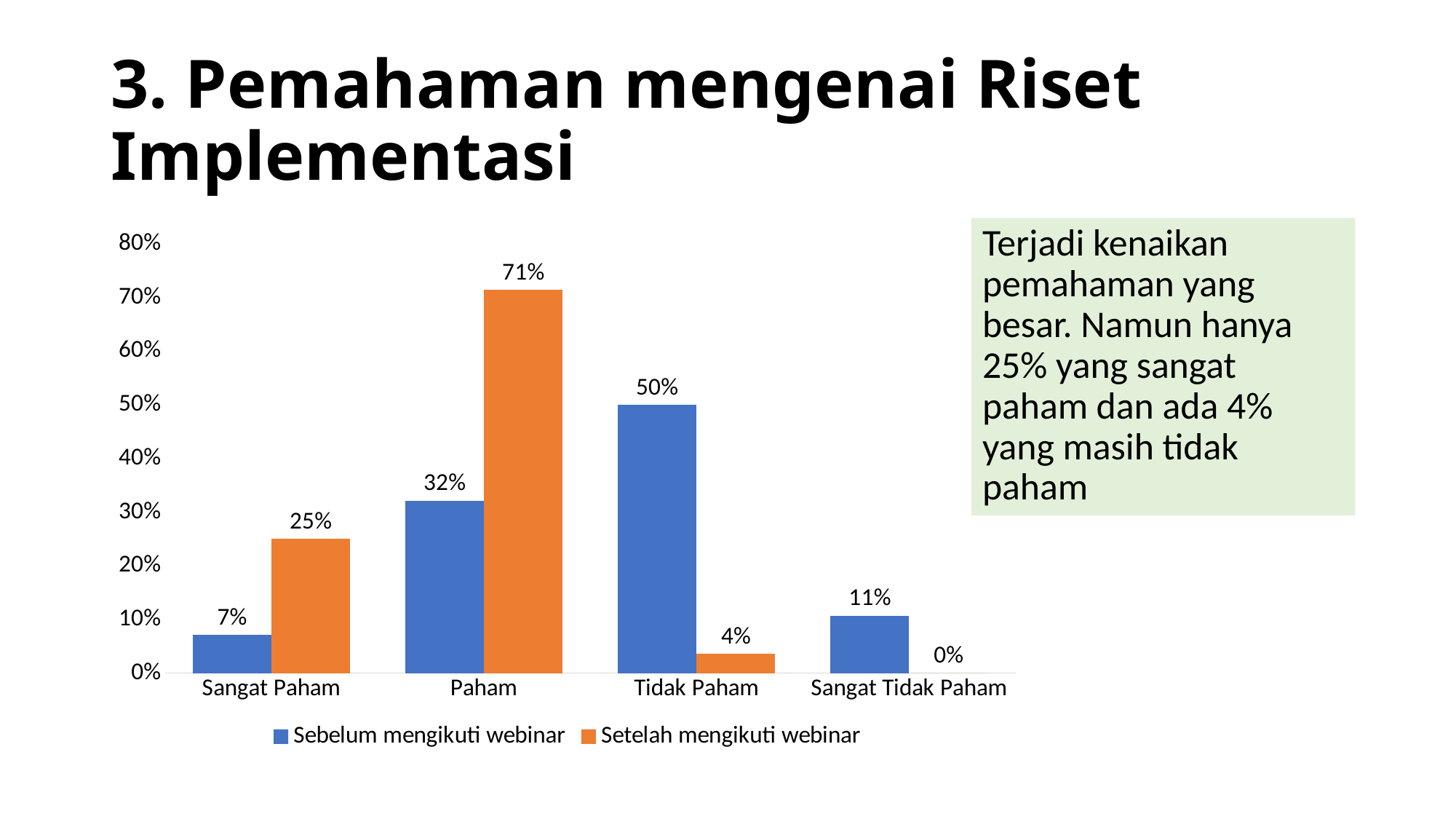
What is the difference between the Setelah mengikuti webinar and Sebelum mengikuti webinar values for Paham? 39% How many categories are shown on the x axis? 4 What is the value for Sangat Tidak Paham in the Setelah mengikuti webinar series? 0% Which is larger for Tidak Paham: the Sebelum mengikuti webinar value or the Setelah mengikuti webinar value? Sebelum mengikuti webinar What is the value for Paham in the Setelah mengikuti webinar series? 71% What is the value for Tidak Paham in the Sebelum mengikuti webinar series? 50% Is the Setelah mengikuti webinar value for Sangat Paham greater or less than 20%? greater What is the value for Sangat Paham in the Sebelum mengikuti webinar series? 7% What kind of chart is shown on the slide? bar chart Which category has the highest value in the Setelah mengikuti webinar series? Paham How many series does the legend list? 2 Which category has the lowest value in the Sebelum mengikuti webinar series? Sangat Paham